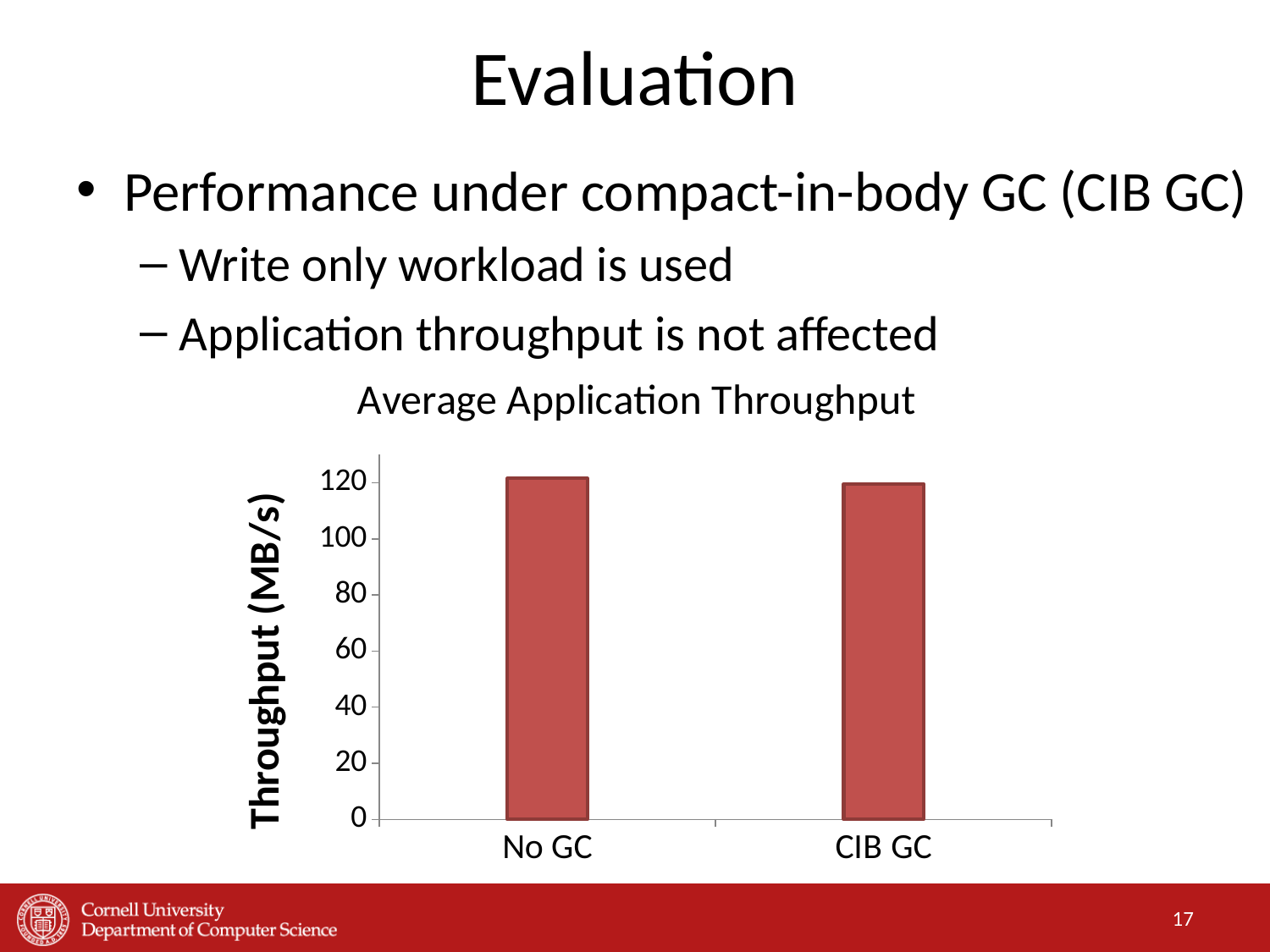
Is the value for No GC greater or less than 100? greater What is the label of the y axis of the chart? Throughput (MB/s) Is the value for CIB GC greater or less than 100? greater What kind of chart is shown on the slide? bar chart Is the value for CIB GC greater or less than 60? greater What is the title of the chart? Average Application Throughput How many categories are plotted on the x axis of the chart? 2